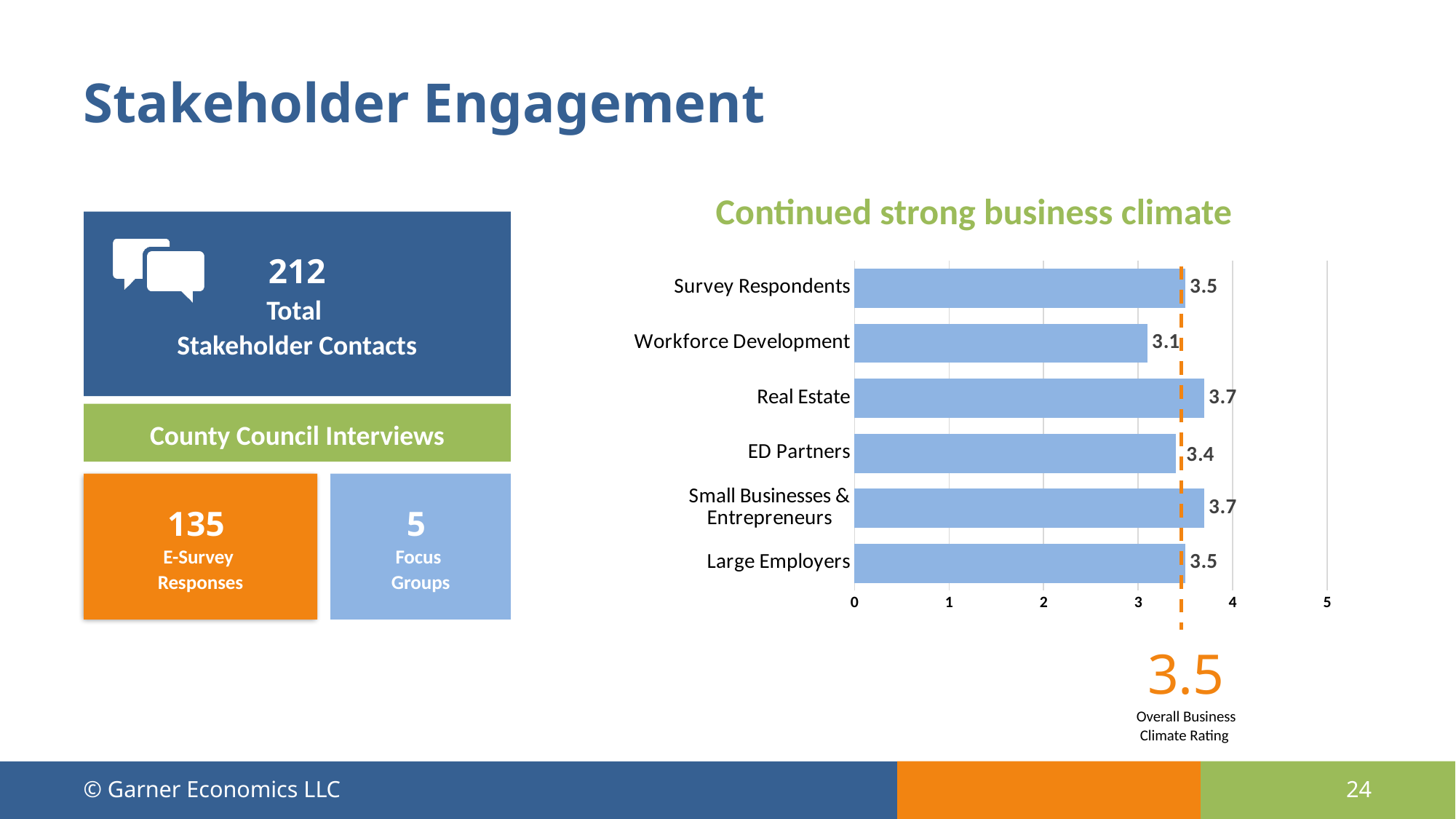
What is the value for Workforce Development? 3.1 Is the value for Workforce Development greater or less than 4? less What is the difference between the values for Real Estate and Workforce Development? 0.6 What is the value for Real Estate? 3.7 What value does the orange dashed line on the chart mark? 3.5 What kind of chart is shown on the slide? bar chart Which is larger, the value for ED Partners or the value for Survey Respondents? Survey Respondents What is the title of the chart? Continued strong business climate What is the value for ED Partners? 3.4 Which category has the lowest value? Workforce Development What is the value for Large Employers? 3.5 How many categories are shown in the chart? 6